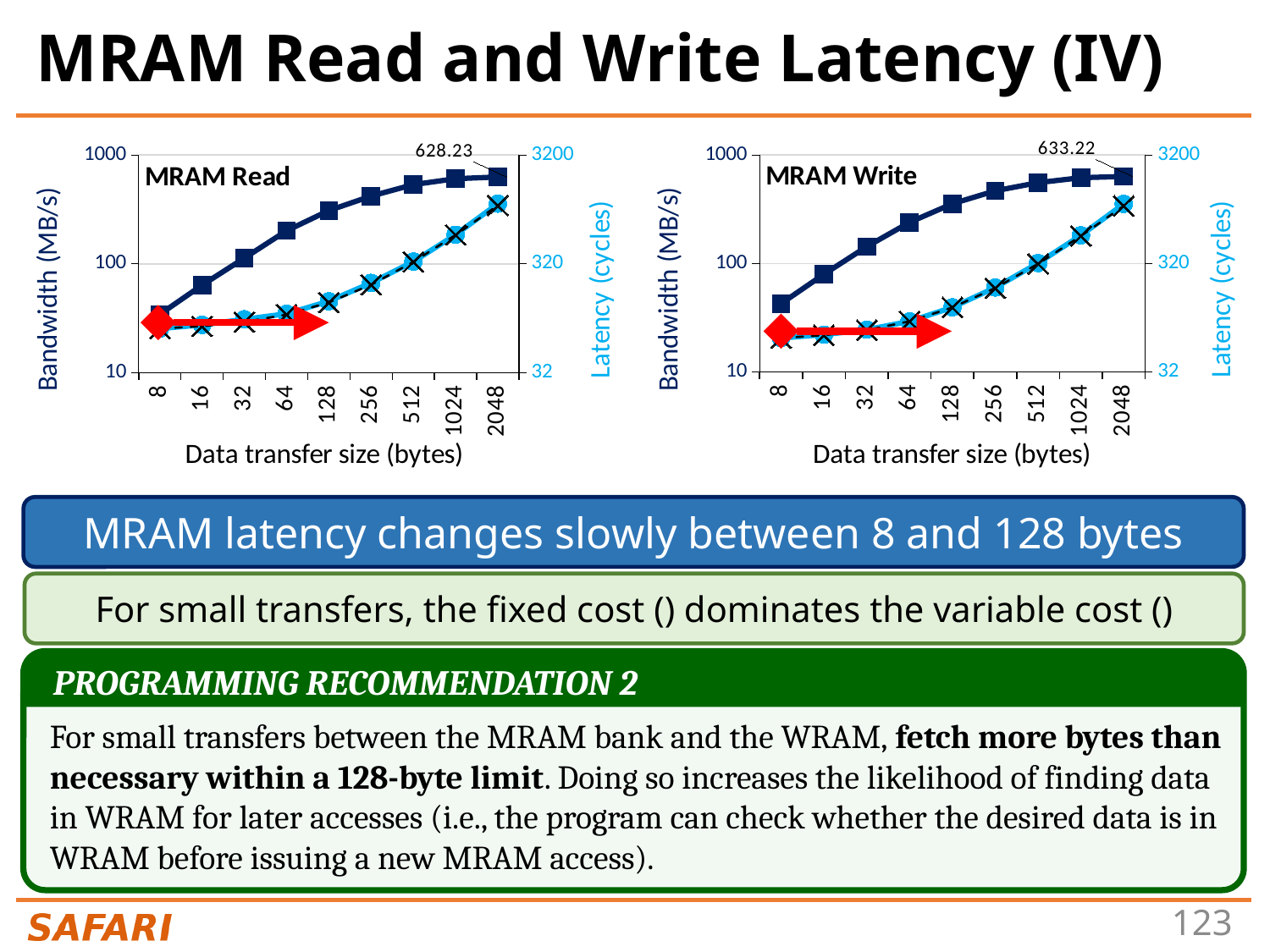
In the MRAM Read chart, is the bandwidth at 8 bytes greater or less than 100 MB/s? less In the MRAM Write chart, is the bandwidth at 512 bytes greater or less than 100 MB/s? greater In the MRAM Read chart, which data transfer size has the highest bandwidth? 2048 Which is larger: the labeled bandwidth at 2048 bytes in the MRAM Read chart or in the MRAM Write chart? MRAM Write In the MRAM Write chart, what is the bandwidth value labeled at a data transfer size of 2048 bytes? 633.22 What is the difference between the labeled 2048-byte bandwidth in the MRAM Write chart and in the MRAM Read chart? 4.99 In the MRAM Read chart, does bandwidth rise or fall as the data transfer size increases? Rises In the MRAM Write chart, is the latency at 2048 bytes greater or less than 320 cycles? greater In the MRAM Write chart, which data transfer size has the lowest bandwidth? 8 In the MRAM Read chart, what is the bandwidth value labeled at a data transfer size of 2048 bytes? 628.23 What kind of chart is the MRAM Write chart? Line chart In the MRAM Read chart, how many data transfer sizes are plotted along the x axis? 9